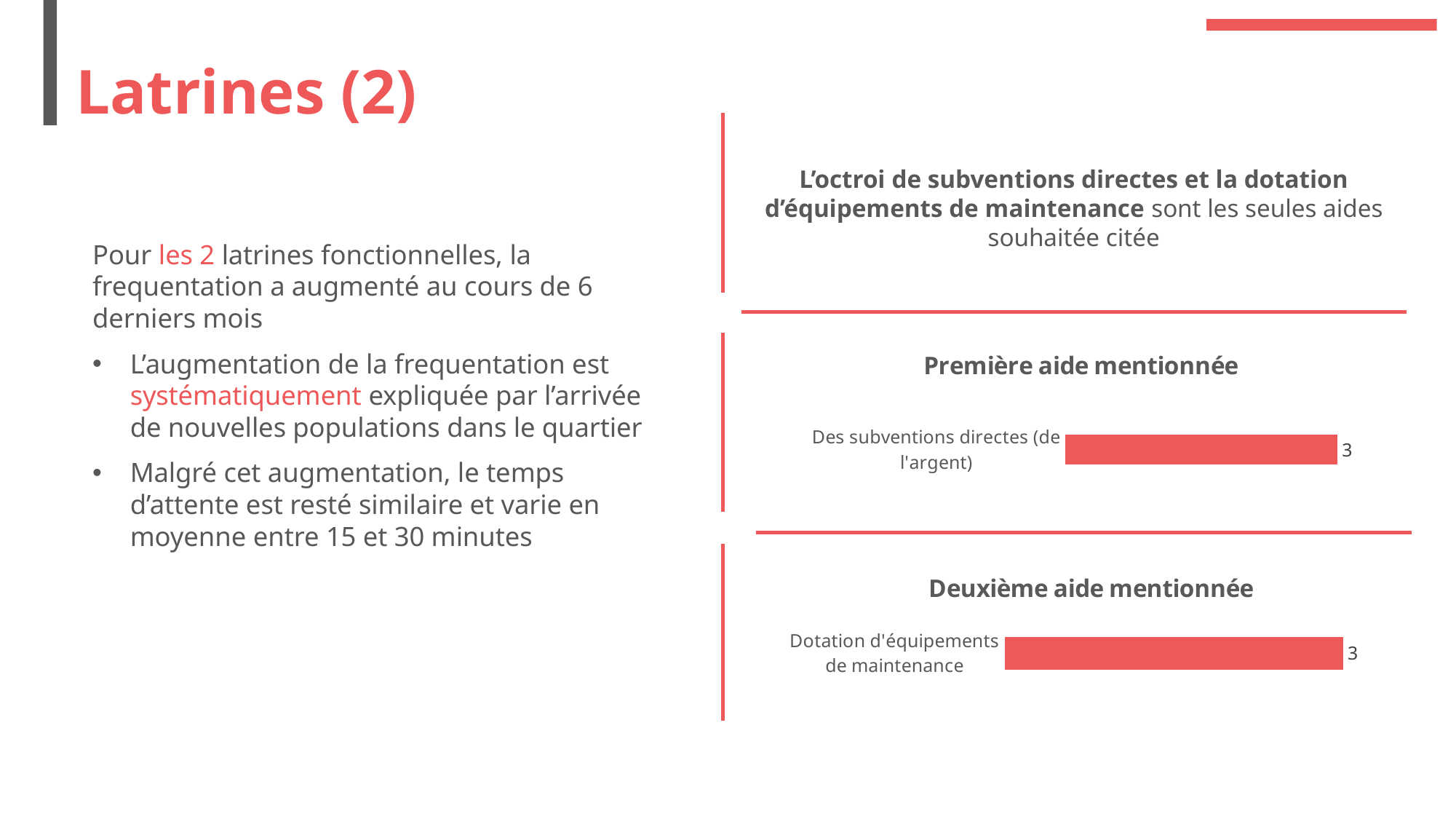
What kind of chart is the chart titled 'Première aide mentionnée'? Bar chart Is the value for 'Des subventions directes (de l'argent)' in the chart titled 'Première aide mentionnée' larger than, smaller than, or equal to the value for 'Dotation d'équipements de maintenance' in the chart titled 'Deuxième aide mentionnée'? Equal What kind of chart is the chart titled 'Deuxième aide mentionnée'? Bar chart What is the title of the upper chart on the slide? Première aide mentionnée What is the category label of the bar in the chart titled 'Deuxième aide mentionnée'? Dotation d'équipements de maintenance In the chart titled 'Deuxième aide mentionnée', what is the value for 'Dotation d'équipements de maintenance'? 3 What is the difference between the value in the chart titled 'Première aide mentionnée' and the value in the chart titled 'Deuxième aide mentionnée'? 0 In the chart titled 'Première aide mentionnée', what is the value for 'Des subventions directes (de l'argent)'? 3 How many categories are shown in the chart titled 'Deuxième aide mentionnée'? 1 How many categories are shown in the chart titled 'Première aide mentionnée'? 1 What colour are the bars in the chart titled 'Deuxième aide mentionnée'? Red